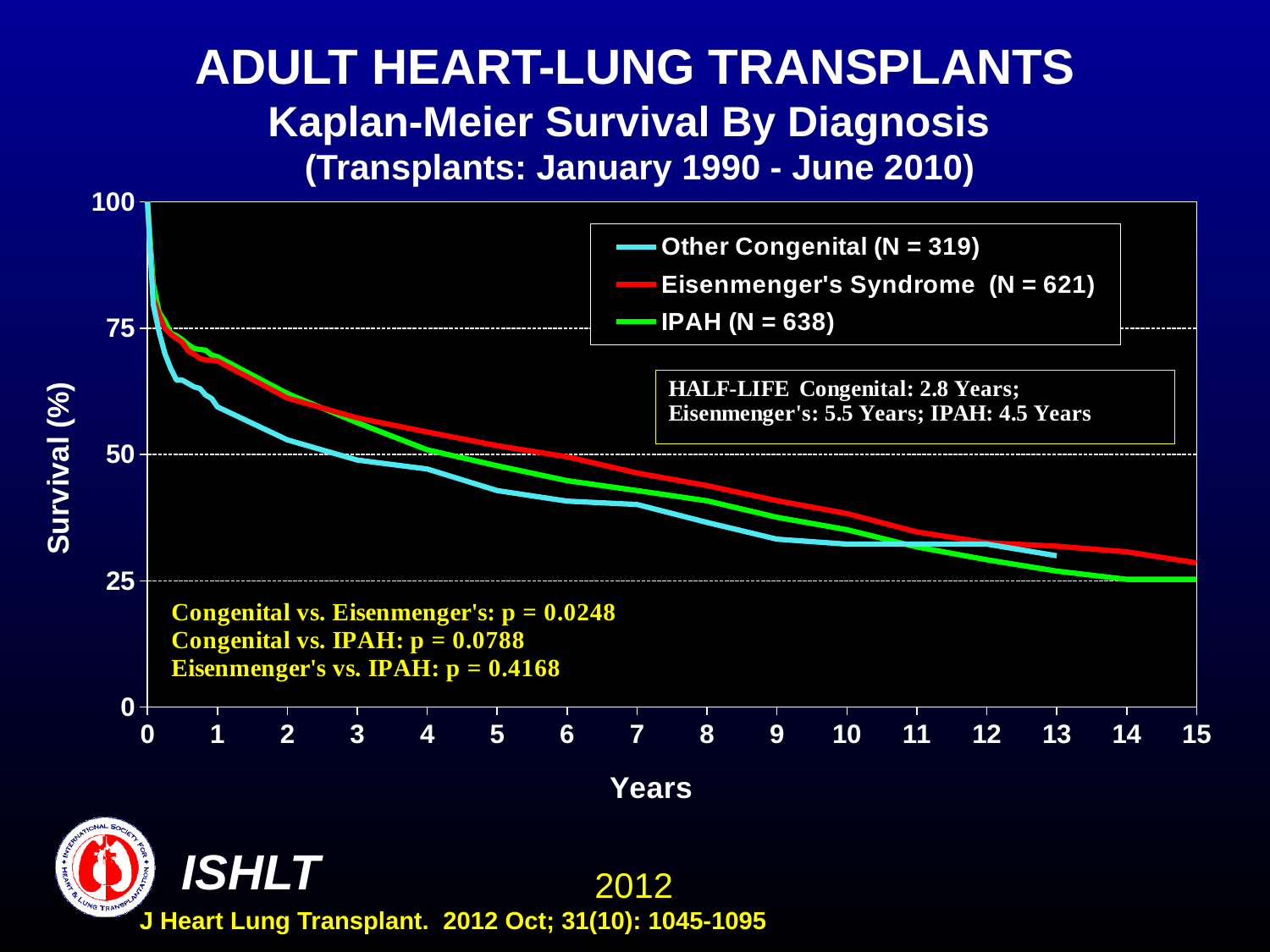
What is the half-life for the IPAH group according to the text box on the chart? 4.5 Years What is the difference in half-life between Eisenmenger's and Congenital? 2.7 Years Which diagnosis group has the longest half-life? Eisenmenger's Do the survival curves rise or fall as years increase? fall What is the p-value for Congenital vs. Eisenmenger's? 0.0248 What is the N for the Eisenmenger's Syndrome group shown in the legend? 621 At 5 years, which curve shows higher survival, Eisenmenger's Syndrome or Other Congenital? Eisenmenger's Syndrome Is the survival for Eisenmenger's Syndrome at 10 years greater or less than 25? greater How many series does the legend list? 3 Is the survival for Other Congenital at 5 years greater or less than 50? less Which diagnosis group has the smallest N in the legend? Other Congenital What kind of chart is shown on the slide? line chart